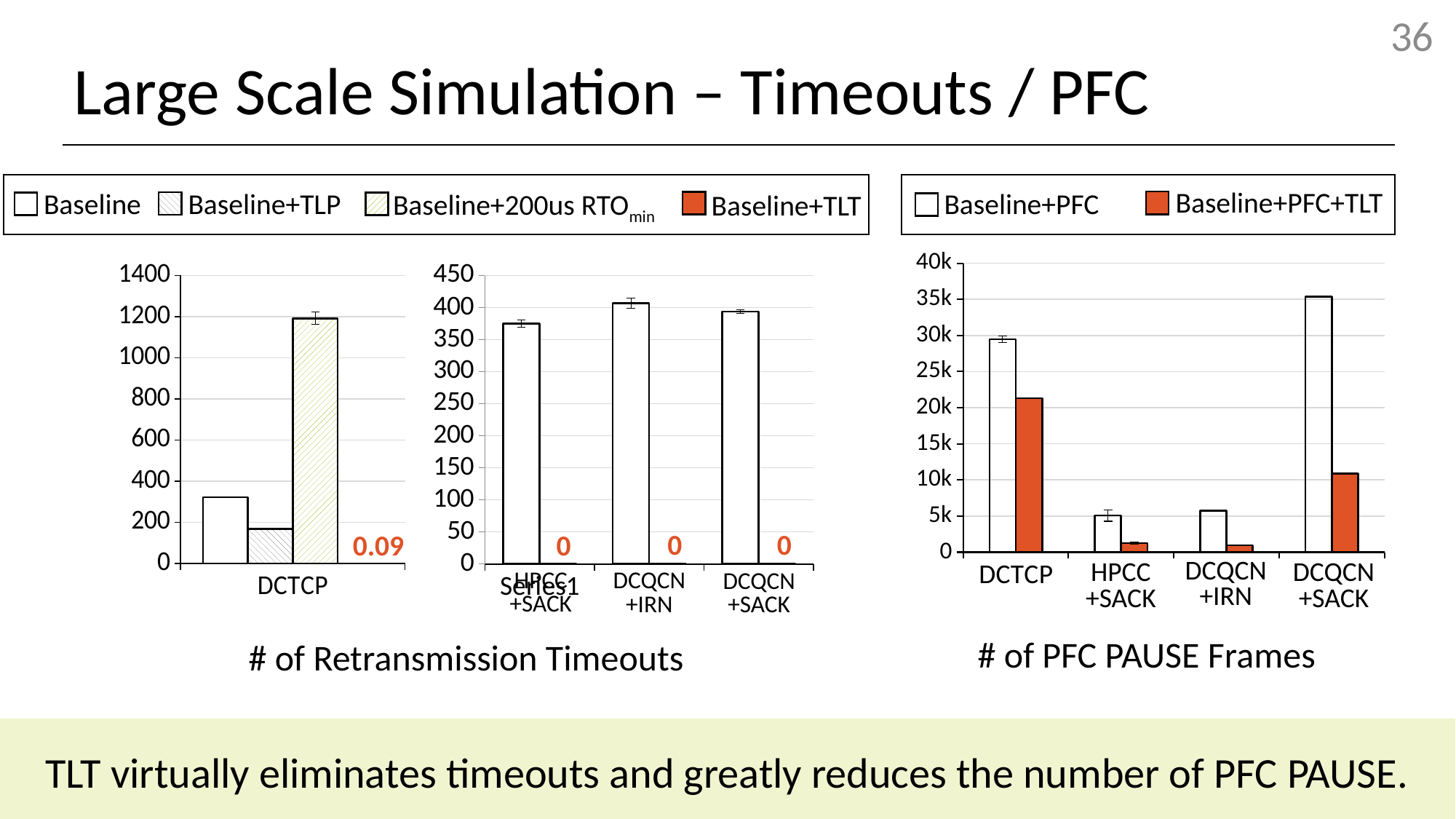
In the right chart (# of PFC PAUSE Frames), how many series does the legend list? 2 In the middle chart (# of Retransmission Timeouts), what is the value for Baseline+TLT for HPCC+SACK? 0 How many series does the legend for the retransmission timeouts charts list? 4 In the right chart (# of PFC PAUSE Frames), is the Baseline+PFC value for DCTCP greater or less than 25k? greater What kind of chart is the right chart (# of PFC PAUSE Frames)? bar chart In the middle chart (# of Retransmission Timeouts), is the Baseline value for DCQCN+IRN greater or less than 350? greater In the left chart (# of Retransmission Timeouts, DCTCP), is the value for Baseline+200us RTOmin greater or less than 1000? greater In the left chart (# of Retransmission Timeouts, DCTCP), which series has the highest value? Baseline+200us RTOmin In the left chart (# of Retransmission Timeouts, DCTCP), what is the value for Baseline+TLT? 0.09 In the right chart (# of PFC PAUSE Frames), which category has the highest Baseline+PFC value? DCQCN+SACK How many categories are shown on the x axis of the middle chart (# of Retransmission Timeouts)? 3